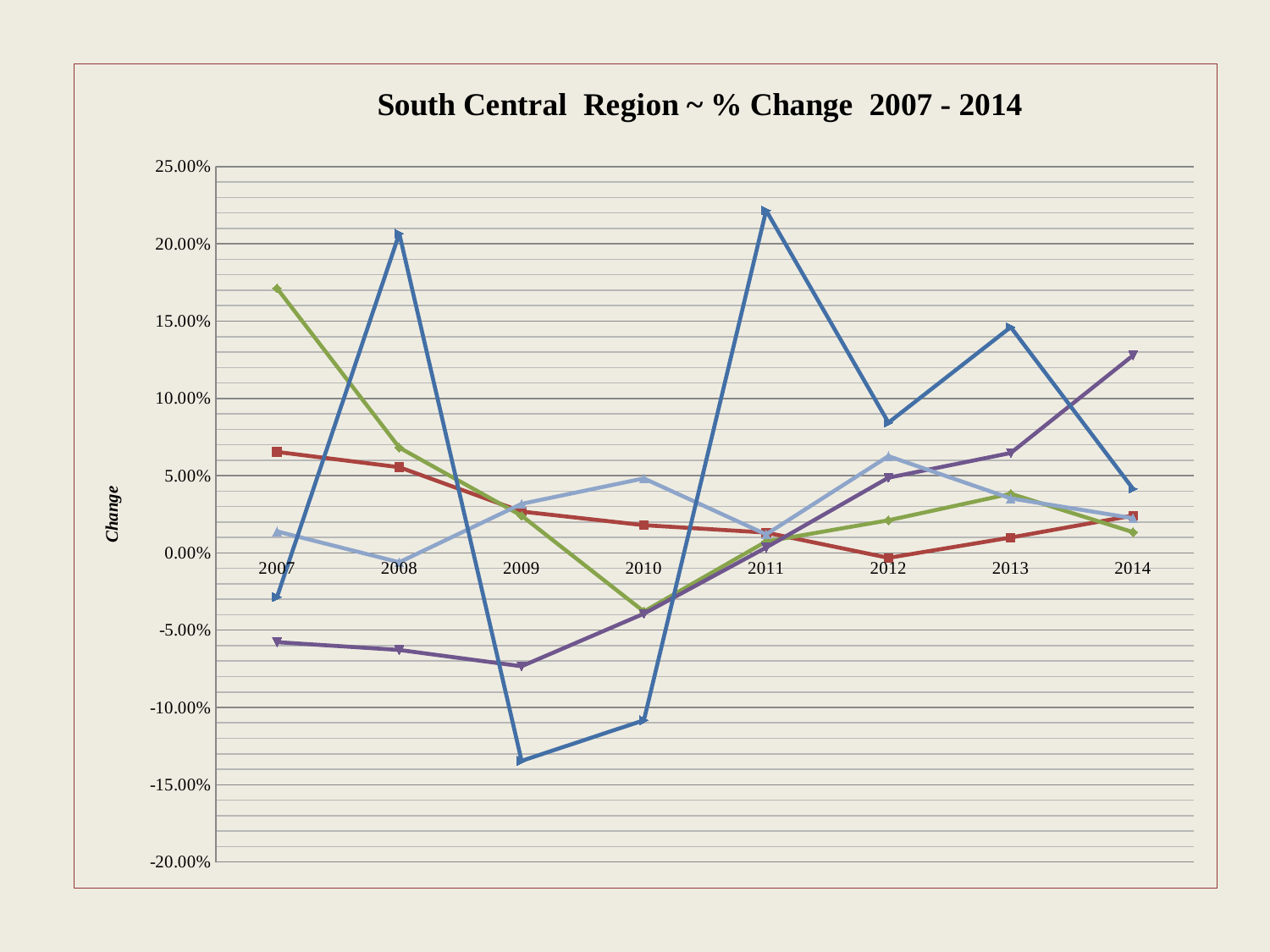
Is the value of the dark blue line in 2011 greater or less than 20.00%? greater Is the value of the dark blue line in 2009 greater or less than -10.00%? less What is the title of the chart? South Central Region ~ % Change 2007 - 2014 Is the value of the purple line in 2014 greater or less than 10.00%? greater Does the purple line rise or fall from 2009 to 2014? rise In which year does the purple line reach its highest value? 2014 In which year does the dark blue line reach its lowest value? 2009 How many lines are plotted on the chart? 5 What is the label on the vertical axis of the chart? Change How many years are shown along the x axis of the chart? 8 What kind of chart is shown on the slide? line chart